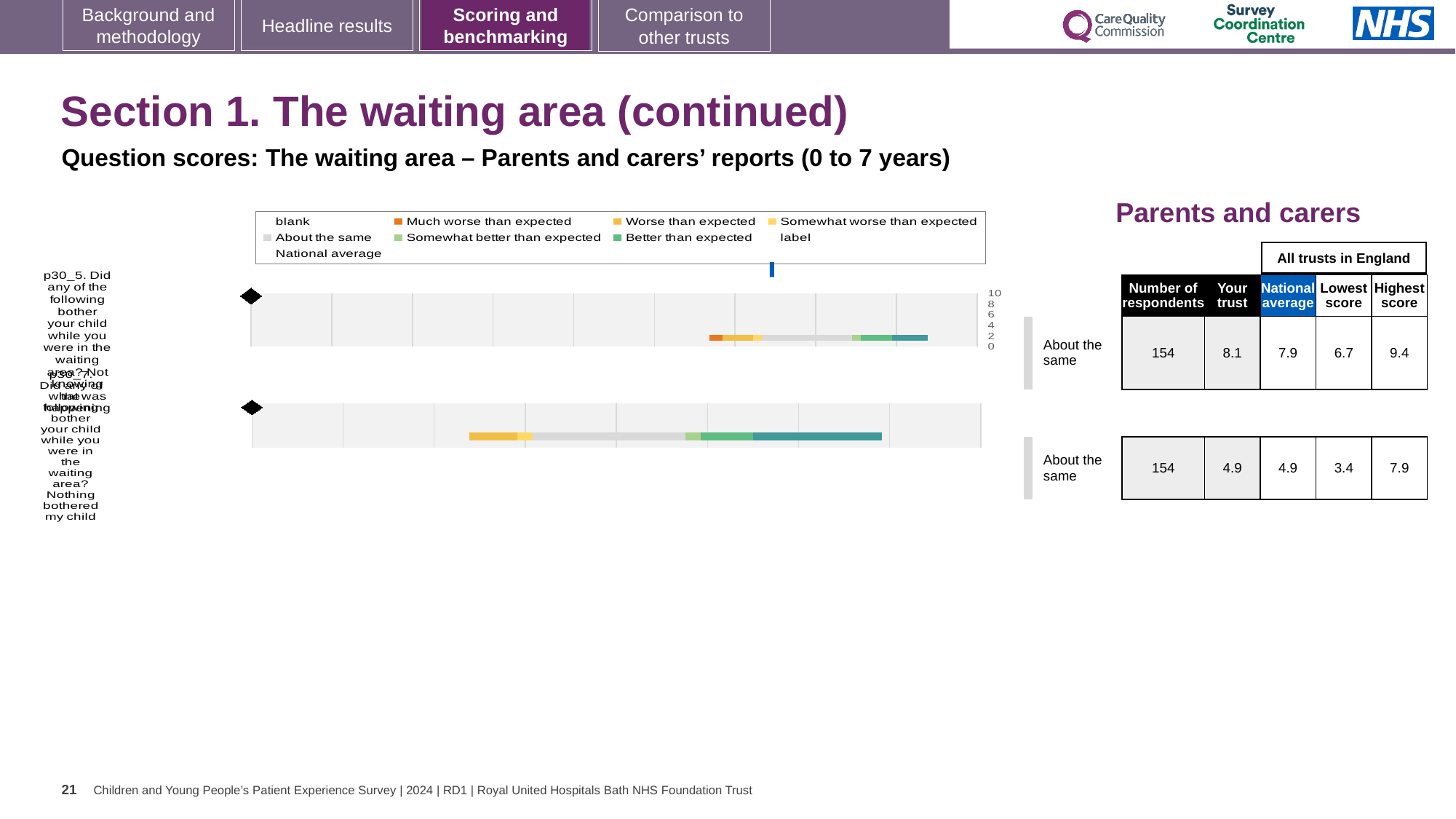
For the bottom bar (p30_7), what is the difference between the highest score and the lowest score across all trusts in England? 4.5 Which legend entry is shown in orange? Much worse than expected What is the national average score for the top bar (p30_5)? 7.9 What is the lowest score among all trusts in England for the bottom bar (p30_7)? 3.4 For the top bar (p30_5), which is larger: the 'Your trust' score or the national average? Your trust How many respondents answered the question shown in the bottom bar (p30_7)? 154 For the top bar (p30_5), what is the difference between the highest score and the lowest score across all trusts in England? 2.7 How many question bars are plotted in the chart? 2 What type of chart is shown on the left of the slide? bar chart What is the highest score among all trusts in England for the top bar (p30_5)? 9.4 What is the 'Your trust' score for the top bar (p30_5, did anything bother your child in the waiting area)? 8.1 What benchmarking category is given for both bars in the chart? About the same